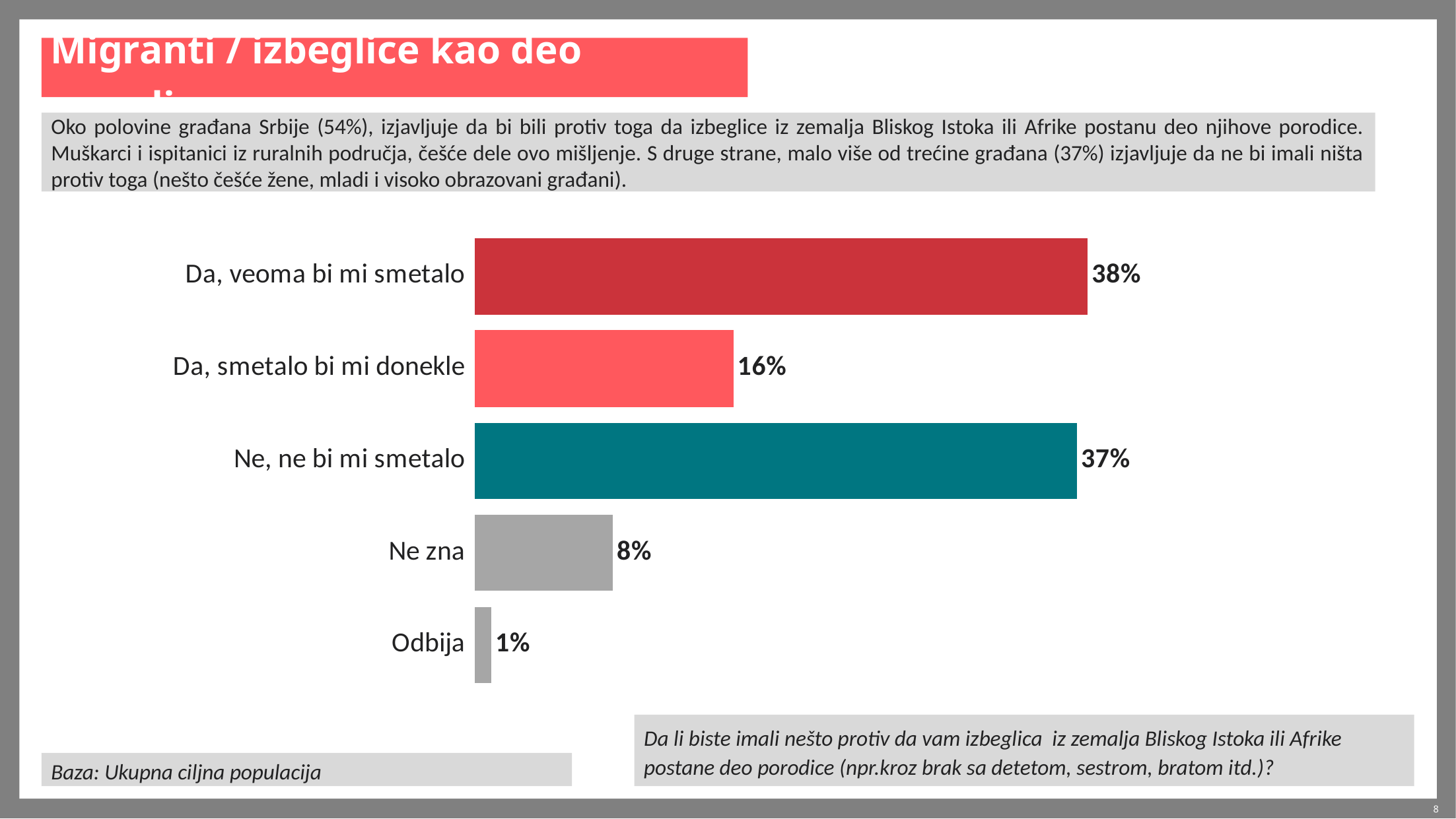
What is the difference between "Da, veoma bi mi smetalo" and "Da, smetalo bi mi donekle"? 22% Which is larger, the value for "Ne, ne bi mi smetalo" or the value for "Ne zna"? Ne, ne bi mi smetalo What is the value for "Odbija"? 1% Which category has the lowest value? Odbija Which category has the highest value? Da, veoma bi mi smetalo What colour is the bar for "Ne, ne bi mi smetalo"? Teal What percentage of respondents answered "Da, veoma bi mi smetalo"? 38% What percentage is shown for "Da, smetalo bi mi donekle"? 16% What type of chart is shown on the slide? Bar chart What is the value for "Ne zna"? 8% How many categories are shown in the chart? 5 What is the value shown for "Ne, ne bi mi smetalo"? 37%